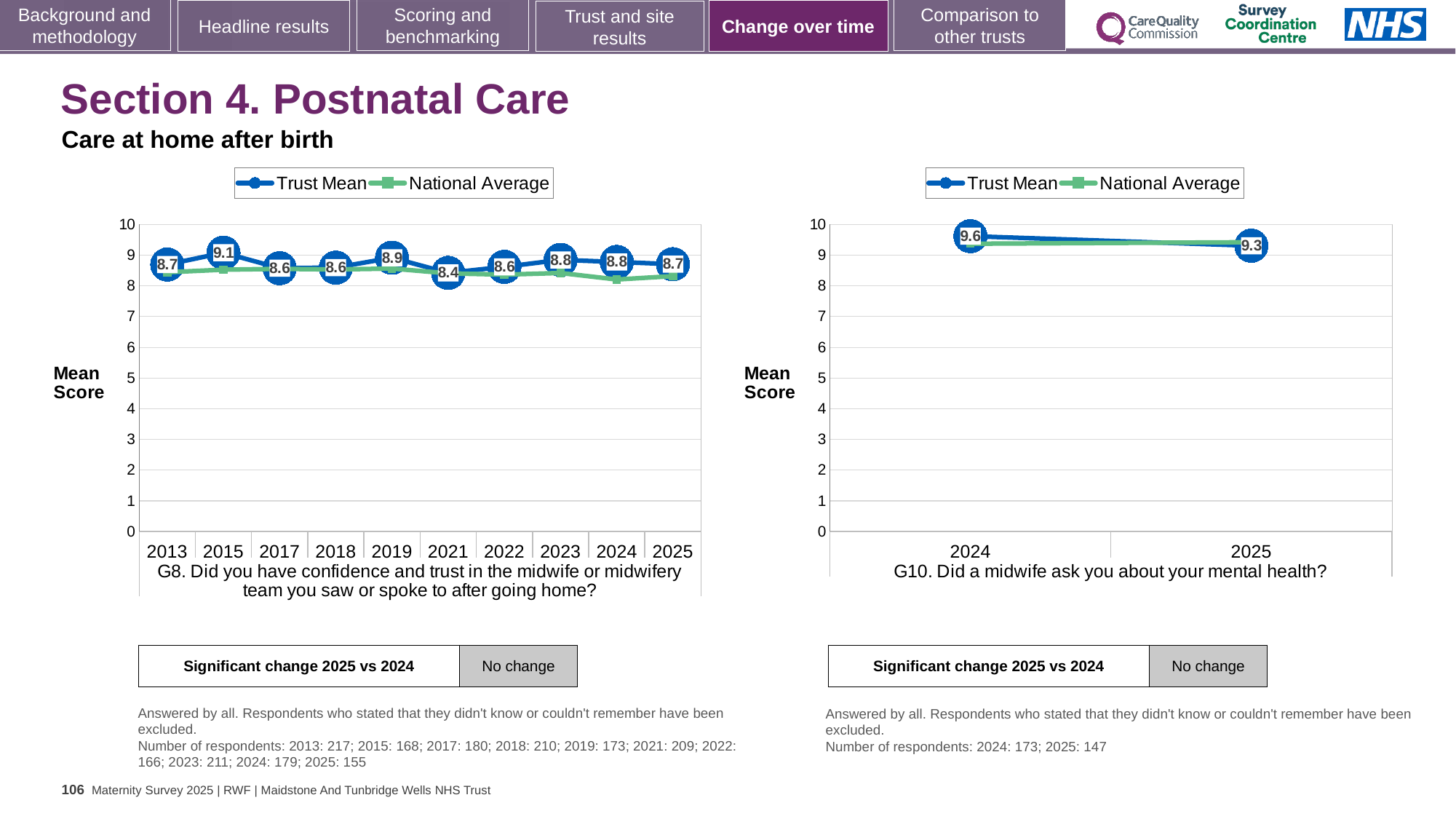
How many series does the legend of the G10 chart list? 2 In the G8 chart, is the Trust Mean higher in 2019 or in 2022? 2019 In the G10 chart, does the Trust Mean rise or fall from 2024 to 2025? fall In the G8 chart, what is the Trust Mean for 2021? 8.4 In the G8 chart, which year has the lowest Trust Mean? 2021 What kind of chart is the G10 chart? line chart In the G10 chart, what is the Trust Mean for 2025? 9.3 How many years are plotted on the x axis of the G8 chart? 10 In the G8 chart, what is the Trust Mean for 2015? 9.1 In the G8 chart, which year has the highest Trust Mean? 2015 In the G8 chart, is the National Average for 2025 greater or less than 9? less In the G8 chart, what is the difference between the Trust Mean in 2015 and in 2021? 0.7